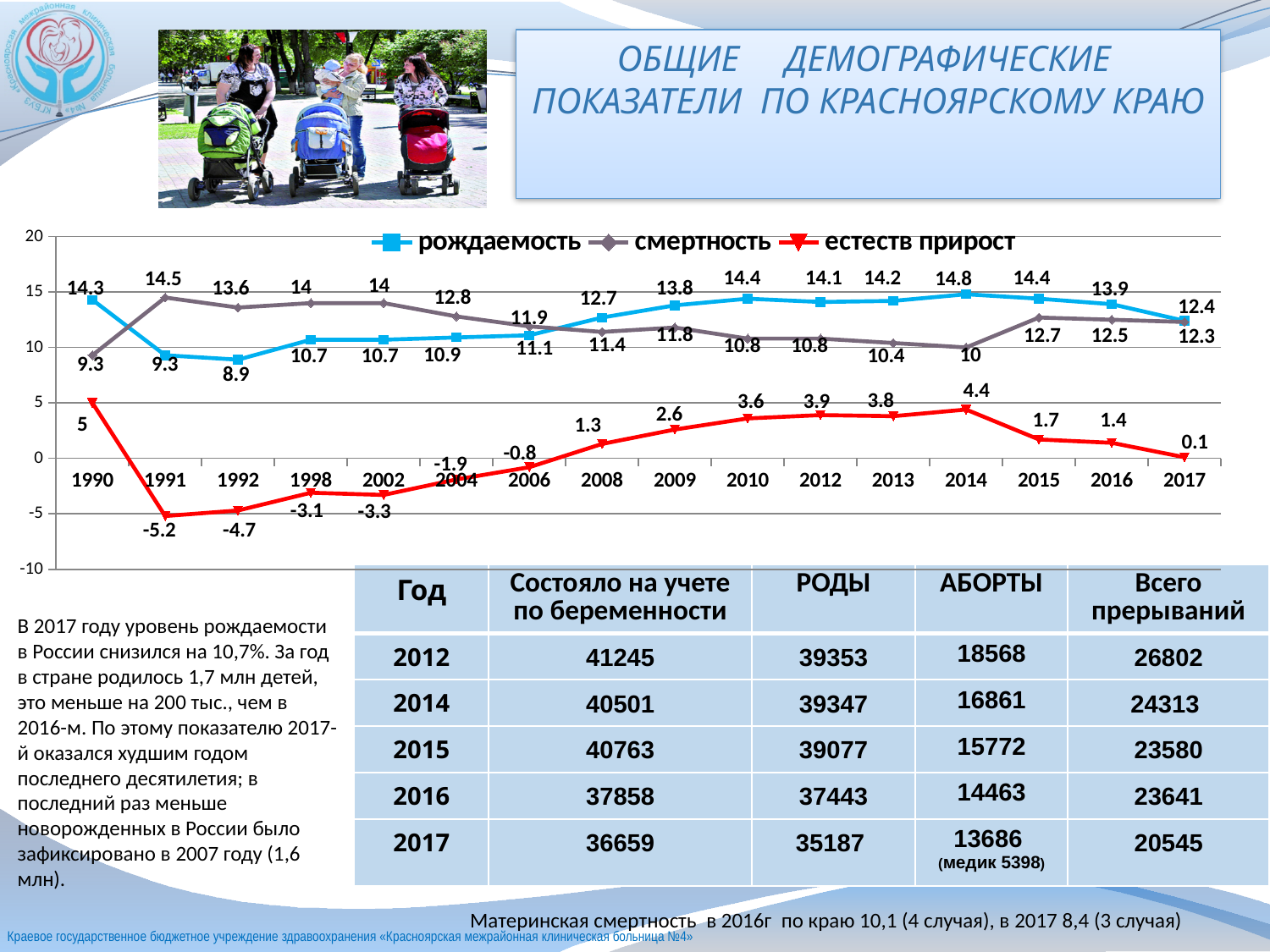
How many series does the chart legend list? 3 Does естеств прирост rise or fall from 2014 to 2017? fall How many years are shown on the x axis of the chart? 16 In which year is естеств прирост lowest? 1991 What is the value of смертность in 1991? 14.5 What is the difference between рождаемость in 2014 and in 2017? 2.4 Which series is drawn in red on the chart? естеств прирост What is the value of рождаемость in 2014? 14.8 What is the value of естеств прирост in 2017? 0.1 In which year is рождаемость highest? 2014 What type of chart is shown on the slide? line chart Which is larger in 1992: рождаемость or смертность? смертность